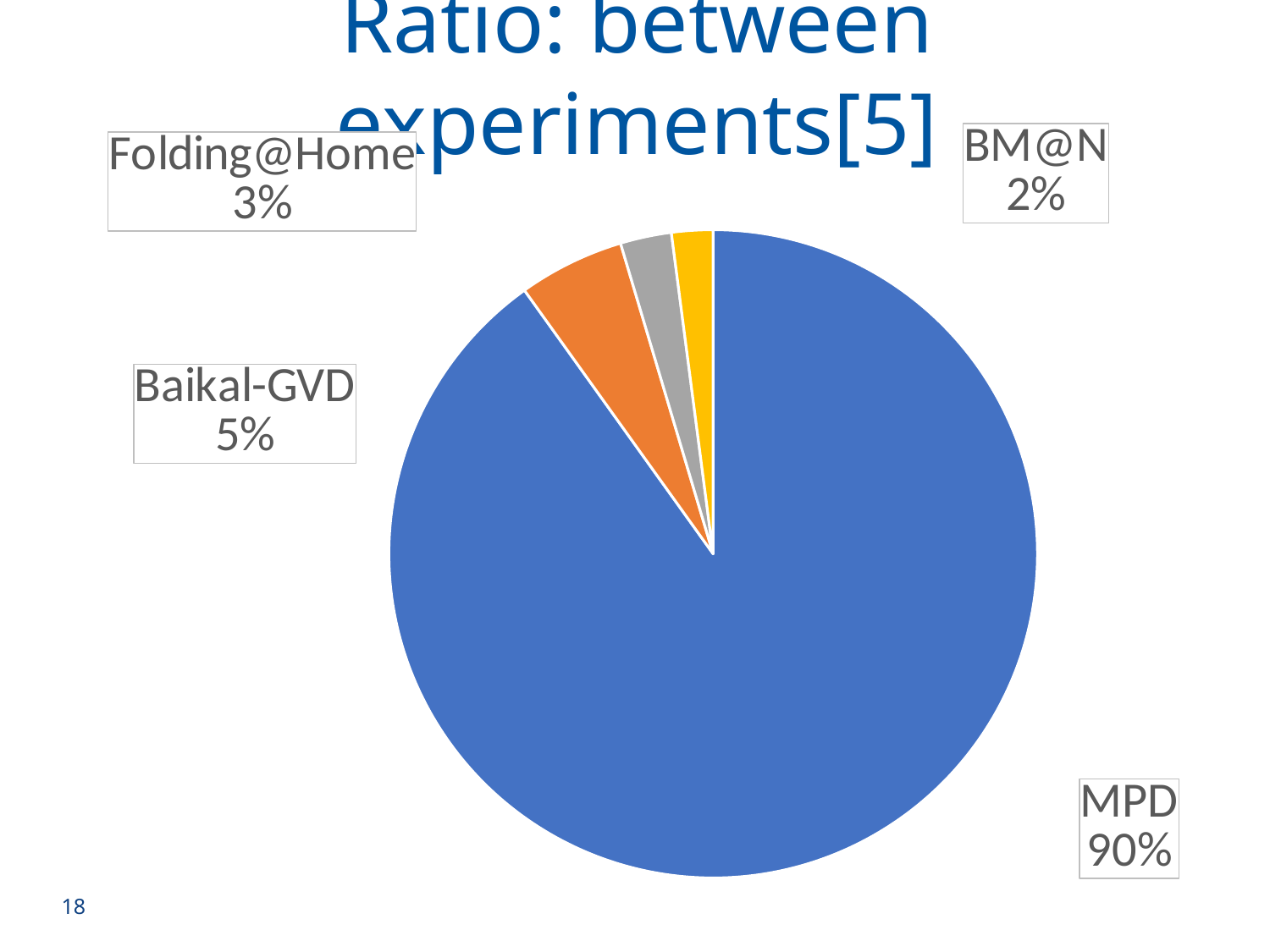
What is the title of the chart? Ratio: between experiments[5] Which experiment has the largest slice of the pie? MPD How many slices does the pie chart have? 4 What share of the pie does Folding@Home have? 3% What is the difference in percentage points between the MPD share and the Baikal-GVD share? 85 What is the combined share of Baikal-GVD, Folding@Home and BM@N? 10% What share of the pie does BM@N have? 2% What share of the pie does MPD have? 90% Which experiment has the smallest slice of the pie? BM@N Which has a larger share, Baikal-GVD or Folding@Home? Baikal-GVD What kind of chart is shown on the slide? pie chart